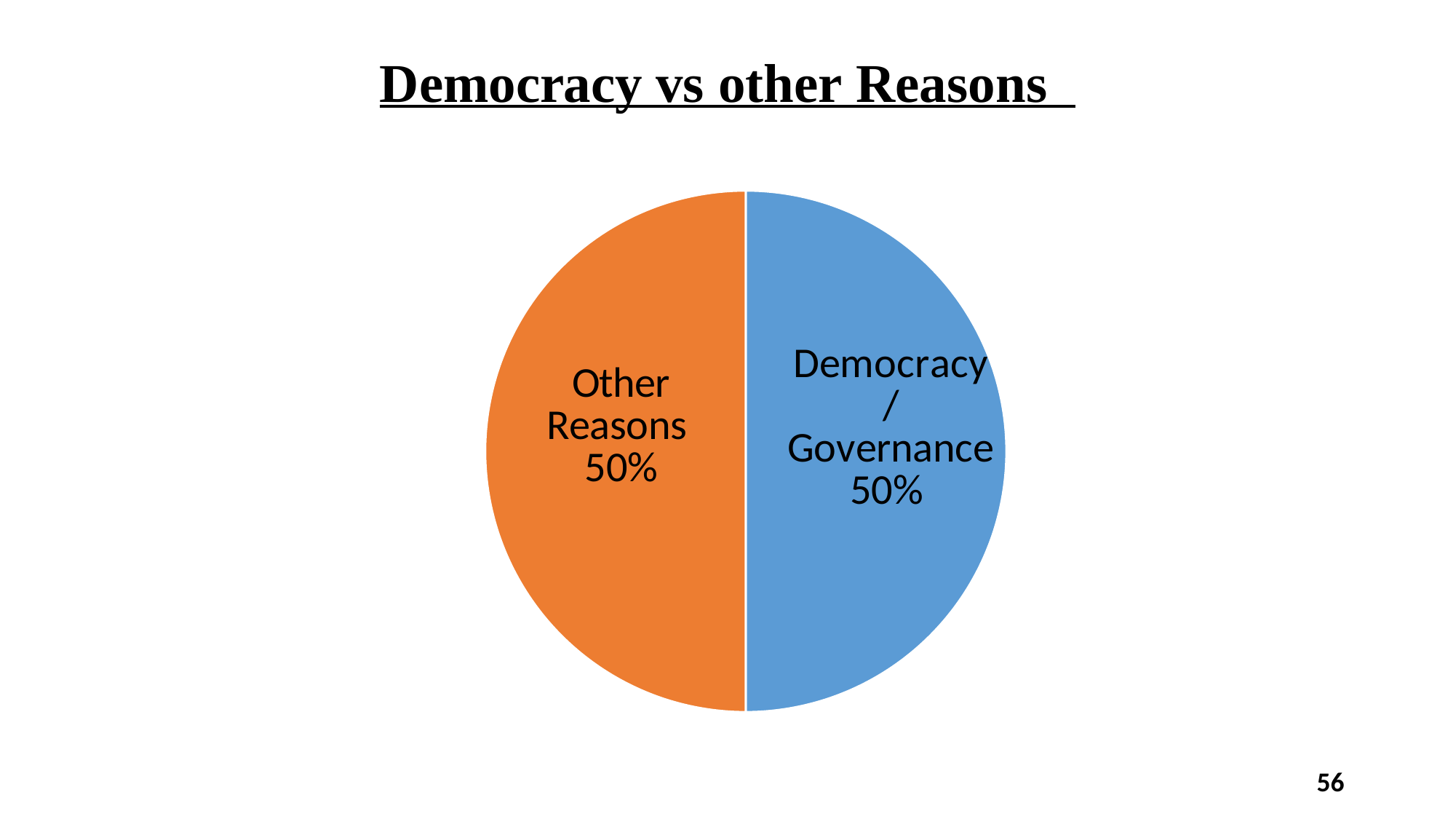
What is the title of the chart? Democracy vs other Reasons What share of the pie is labelled Other Reasons? 50% What is the combined share of the Other Reasons and Democracy / Governance slices? 100% What colour is the Democracy / Governance slice? Blue What kind of chart is shown on the slide? Pie chart What is the difference between the Other Reasons share and the Democracy / Governance share? 0% What share of the pie is labelled Democracy / Governance? 50% Is the share for Other Reasons greater or less than 25%? greater How many slices does the pie chart have? 2 Is the share for Democracy / Governance greater or less than 75%? less